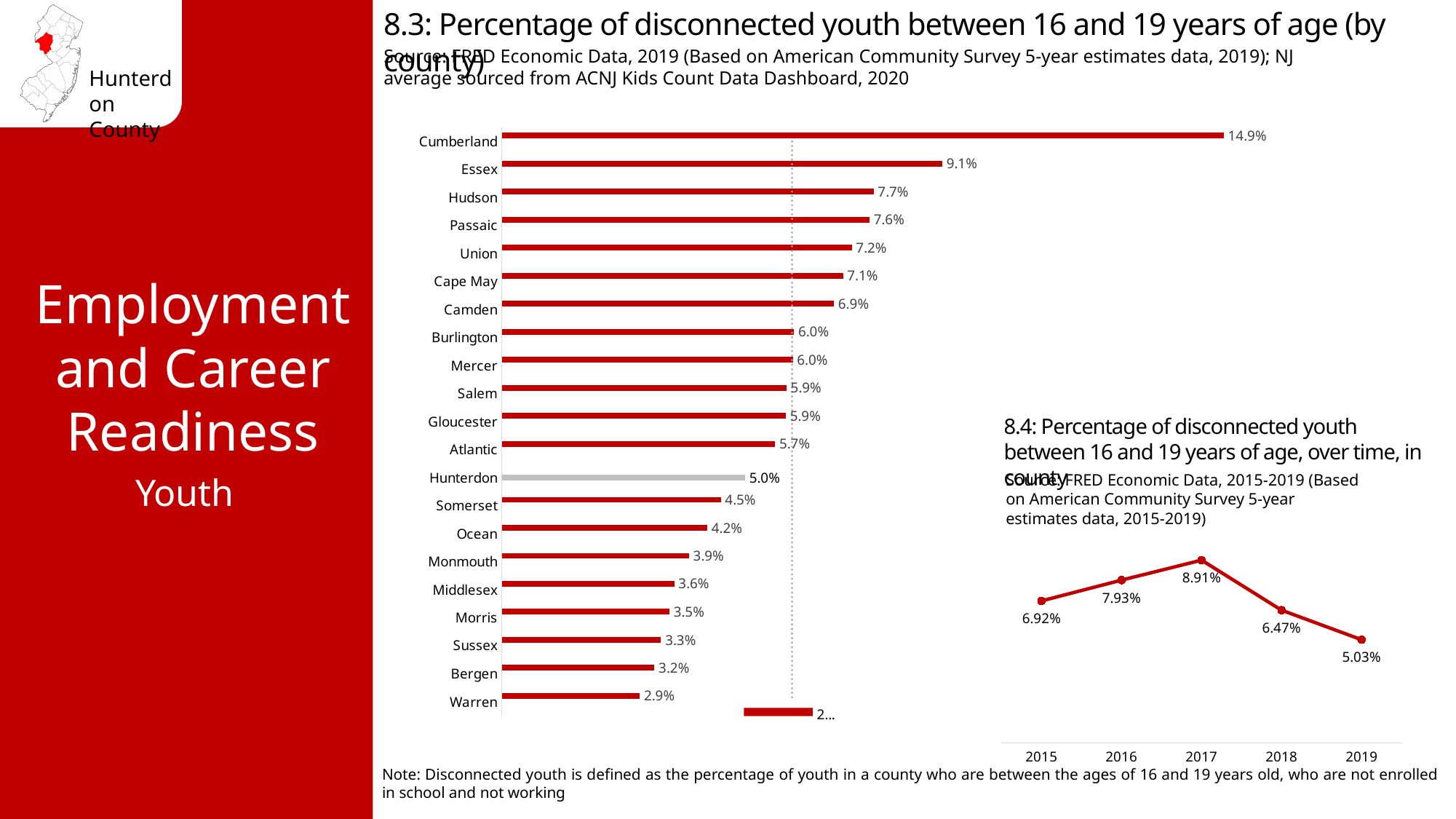
In chart 8.3 (by county), what is the percentage of disconnected youth for Hunterdon? 5.0% In chart 8.4 (over time), how many years are plotted? 5 What kind of chart is chart 8.3 (by county)? Bar chart In chart 8.3 (by county), which has a higher value, Somerset or Ocean? Somerset What kind of chart is chart 8.4 (over time)? Line chart In chart 8.4 (over time), what is the percentage of disconnected youth in 2017? 8.91% In chart 8.3 (by county), which labeled county has the lowest percentage of disconnected youth? Warren In chart 8.3 (by county), what is the percentage of disconnected youth for Cumberland? 14.9% In chart 8.4 (over time), which year has the lowest percentage of disconnected youth? 2019 In chart 8.3 (by county), which county has the highest percentage of disconnected youth? Cumberland In chart 8.4 (over time), what is the difference between the 2017 and 2019 values? 3.88% In chart 8.3 (by county), what is the difference between the values for Essex and Hudson? 1.4%